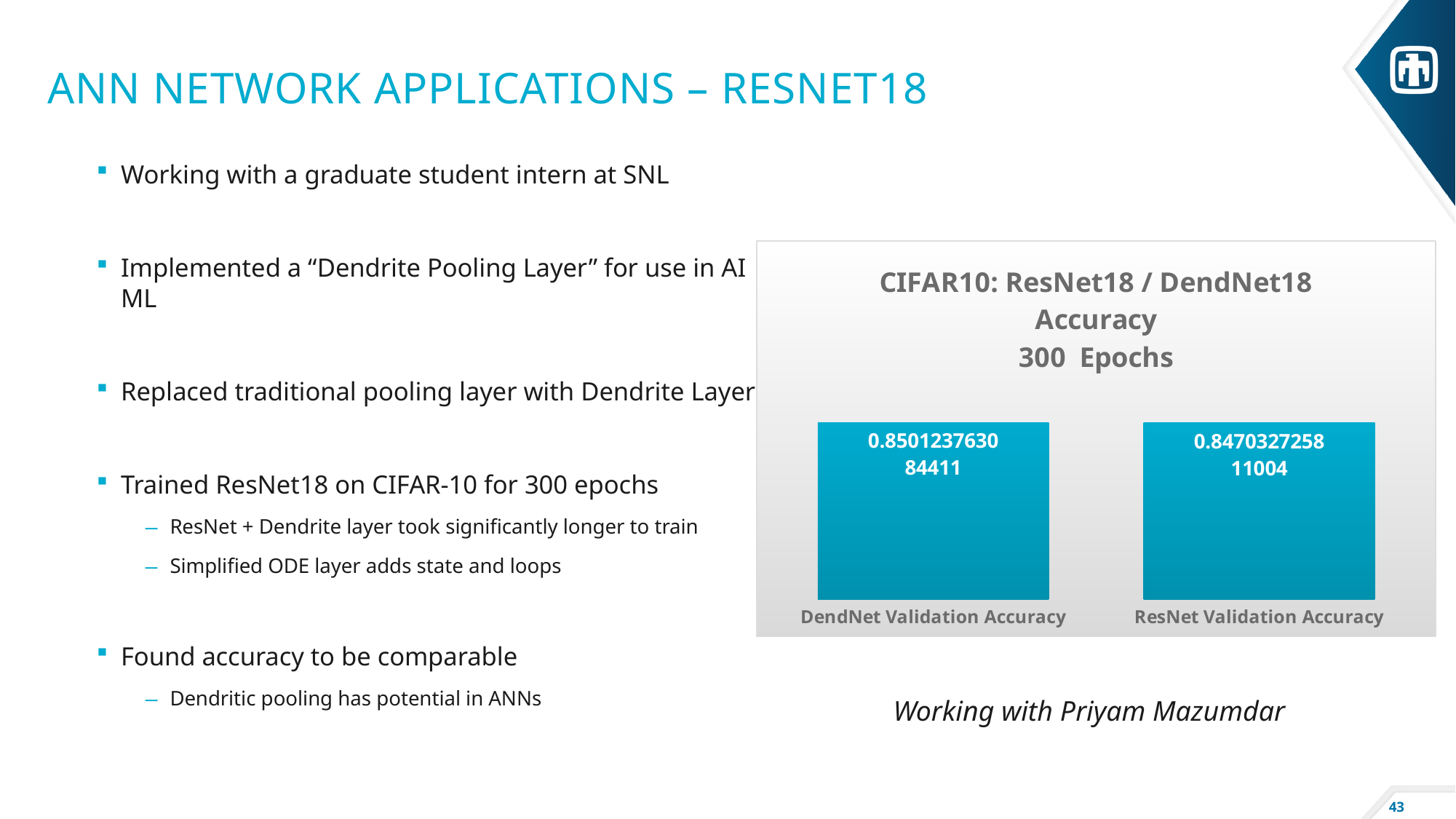
What colour are the bars in the chart? Blue Which category has the highest value in the chart? DendNet Validation Accuracy Which category has the lowest value in the chart? ResNet Validation Accuracy How many categories are shown in the chart? 2 What is the title of the chart? CIFAR10: ResNet18 / DendNet18 Accuracy 300 Epochs What is the value for ResNet Validation Accuracy? 0.847032725811004 What kind of chart is shown on the slide? Bar chart Which category has the higher value, DendNet Validation Accuracy or ResNet Validation Accuracy? DendNet Validation Accuracy What is the difference between the DendNet Validation Accuracy and the ResNet Validation Accuracy values? 0.003091037273407 What is the value for DendNet Validation Accuracy? 0.850123763084411